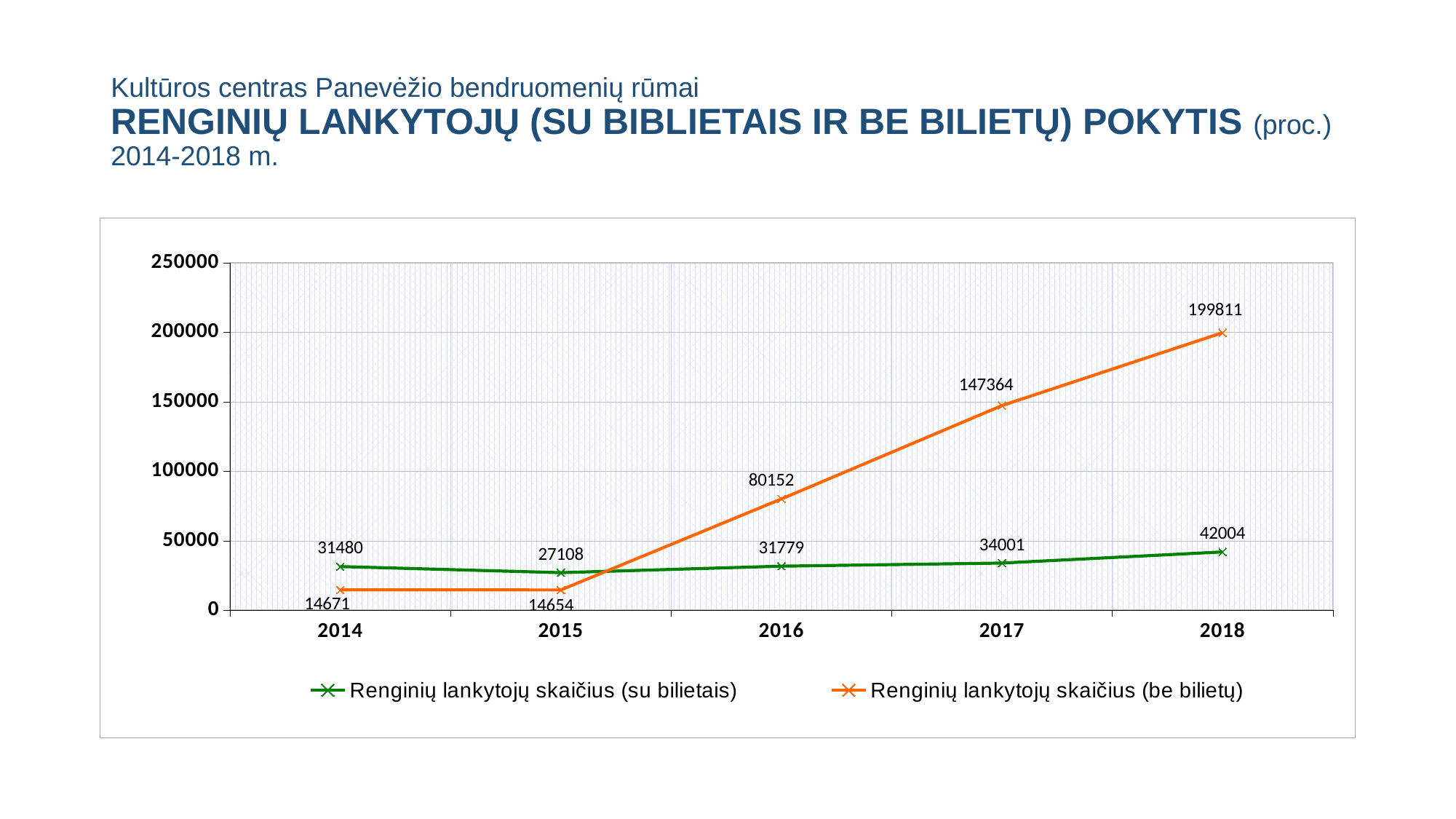
What kind of chart is shown on the slide? line chart Does the 'Renginių lankytojų skaičius (be bilietų)' series rise or fall from 2015 to 2018? rise In which year is 'Renginių lankytojų skaičius (su bilietais)' lowest? 2015 What is the value for 'Renginių lankytojų skaičius (be bilietų)' in 2014? 14671 What is the value for 'Renginių lankytojų skaičius (su bilietais)' in 2018? 42004 How many years are shown on the x axis? 5 What is the difference between the 'be bilietų' value in 2018 and in 2017? 52447 In which year is 'Renginių lankytojų skaičius (be bilietų)' highest? 2018 What is the value for 'Renginių lankytojų skaičius (be bilietų)' in 2016? 80152 How many series does the legend list? 2 Is the value for 'Renginių lankytojų skaičius (be bilietų)' in 2017 greater or less than 100000? greater Which series has the larger value in 2015, 'su bilietais' or 'be bilietų'? su bilietais